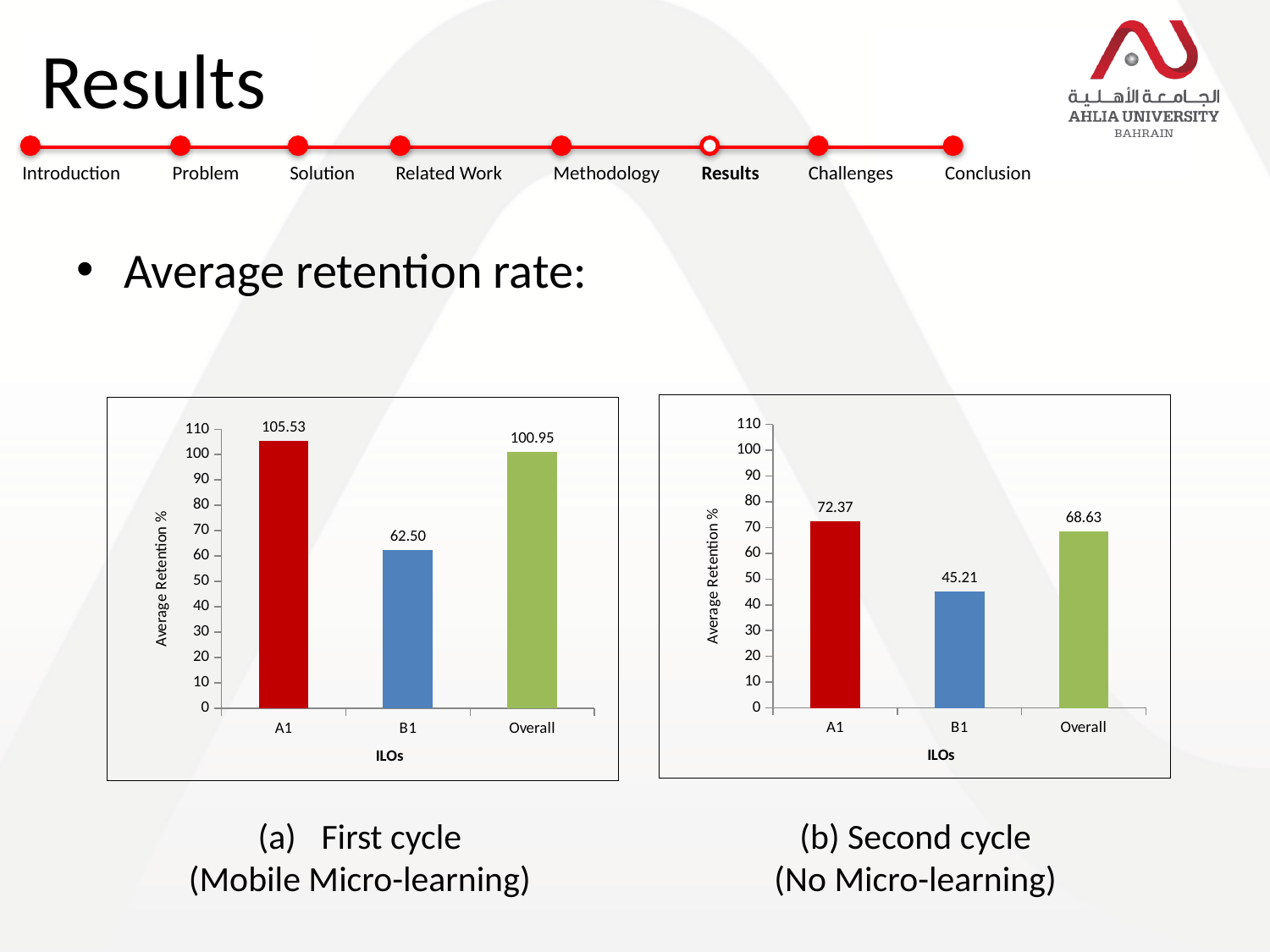
In the right chart (Second cycle, No Micro-learning), what is the average retention % for B1? 45.21 In the left chart (First cycle, Mobile Micro-learning), what is the average retention % for A1? 105.53 In the left chart (First cycle, Mobile Micro-learning), what is the average retention % for B1? 62.50 How many ILO categories are shown on the x axis of the right chart (Second cycle, No Micro-learning)? 3 In the right chart (Second cycle, No Micro-learning), which ILO category has the highest average retention %? A1 What type of chart is the left chart (First cycle, Mobile Micro-learning)? Bar chart What is the y-axis label of the right chart (Second cycle, No Micro-learning)? Average Retention % In the left chart (First cycle, Mobile Micro-learning), which ILO category has the lowest average retention %? B1 In the right chart (Second cycle, No Micro-learning), what is the average retention % for Overall? 68.63 Which is larger: the A1 value in the left chart (First cycle) or the A1 value in the right chart (Second cycle)? Left chart (First cycle), 105.53 In the left chart (First cycle, Mobile Micro-learning), what is the difference between the A1 and B1 values? 43.03 In the right chart (Second cycle, No Micro-learning), what is the difference between the A1 and Overall values? 3.74